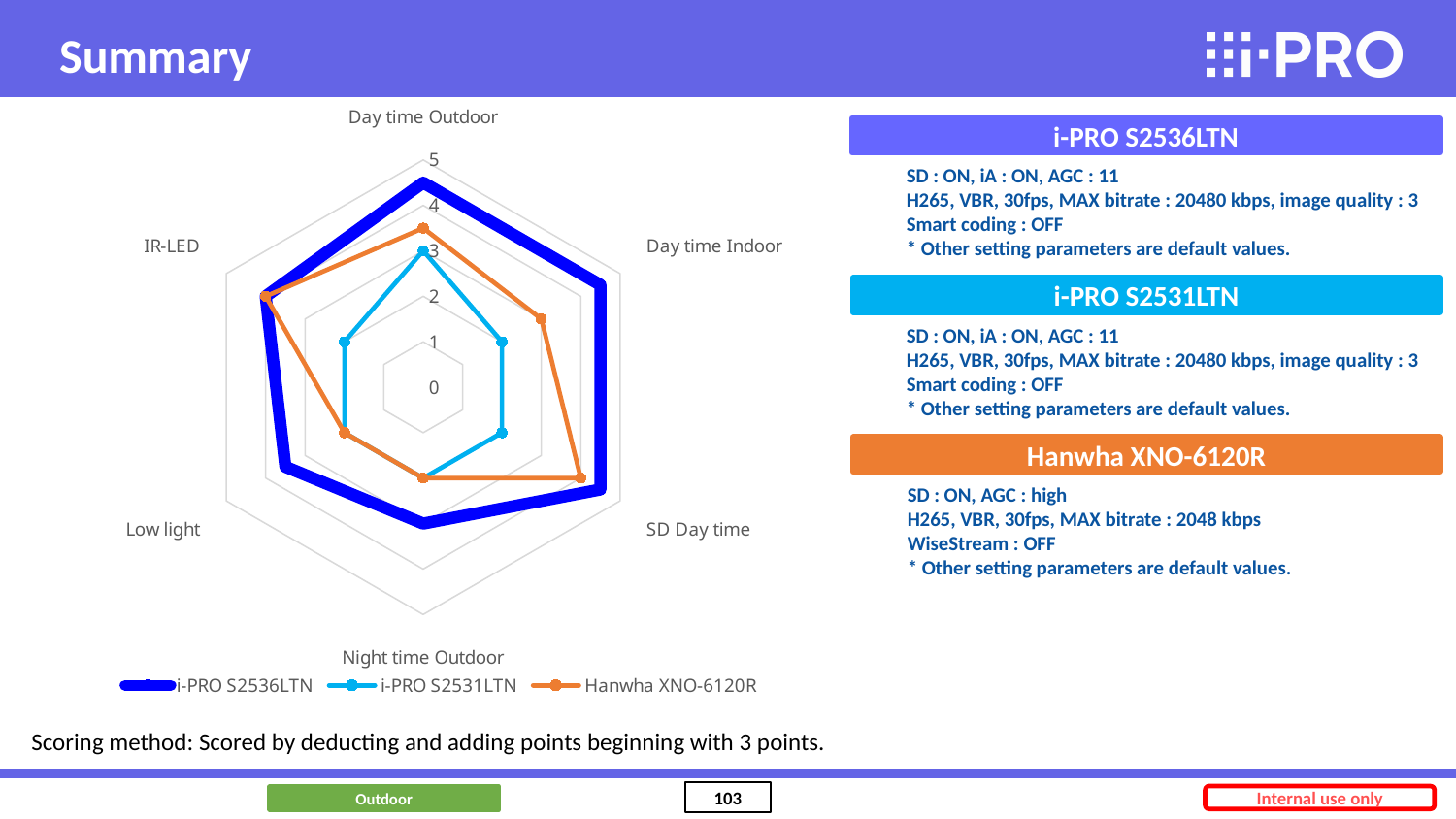
How many series does the chart legend list? 3 What is the score of Hanwha XNO-6120R for Night time Outdoor? 2 What is the score of i-PRO S2531LTN for Day time Outdoor? 3 What kind of chart is shown on the slide? Radar chart Which series has the highest score for Day time Outdoor? i-PRO S2536LTN For IR-LED, which scores higher: Hanwha XNO-6120R or i-PRO S2531LTN? Hanwha XNO-6120R Is the score of i-PRO S2536LTN for Night time Outdoor greater or less than 4? less How many categories (axes) does the radar chart have? 6 What colour is used for the Hanwha XNO-6120R series in the chart? Orange What is the maximum value shown on the chart's scale? 5 For SD Day time, which scores higher: Hanwha XNO-6120R or i-PRO S2531LTN? Hanwha XNO-6120R